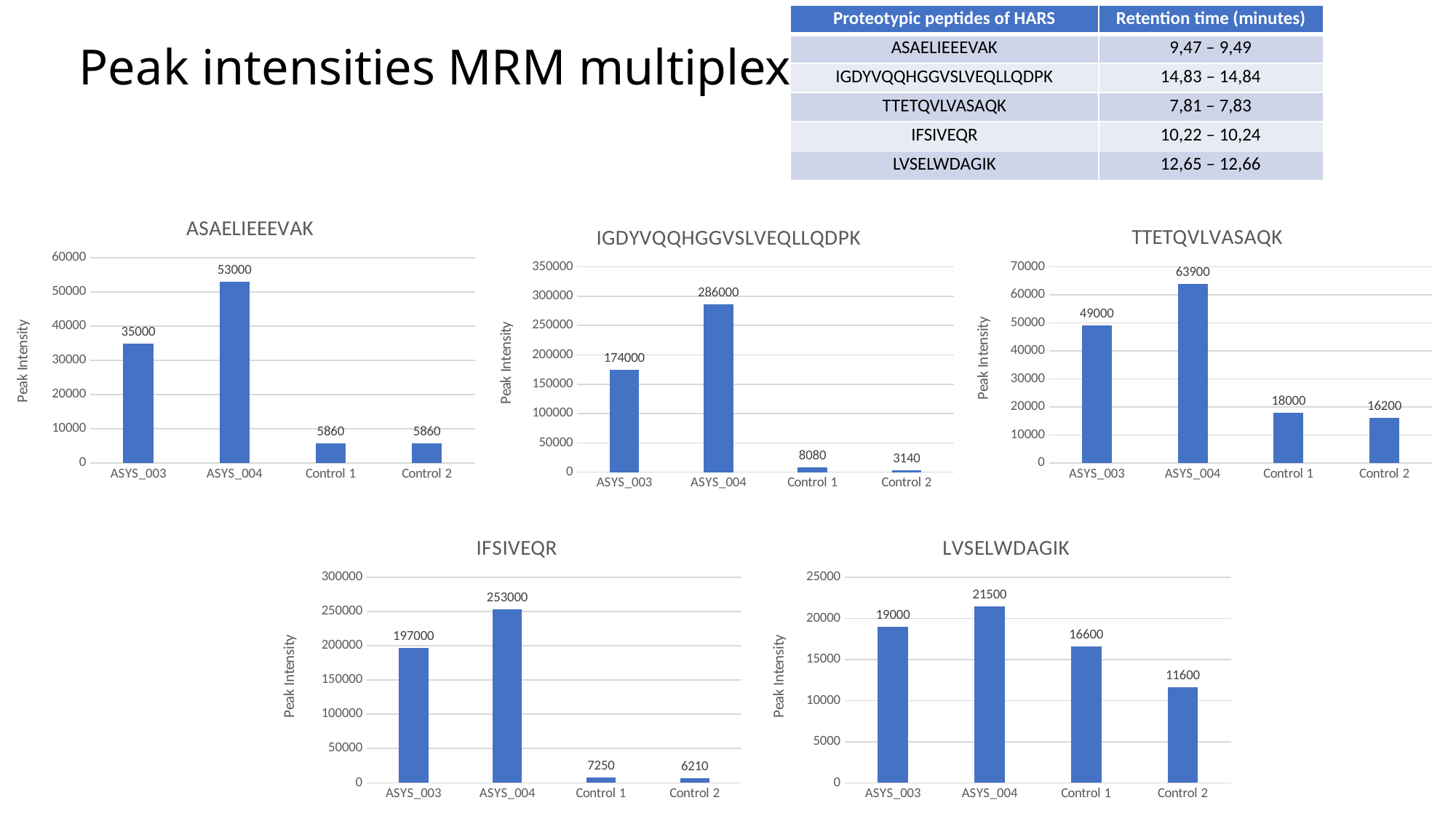
In the IGDYVQQHGGVSLVEQLLQDPK chart, what is the peak intensity for Control 2? 3140 In the ASAELIEEEVAK chart, what is the peak intensity for ASYS_004? 53000 In the TTETQVLVASAQK chart, which is larger, the value for Control 1 or Control 2? Control 1 In the TTETQVLVASAQK chart, which category has the highest peak intensity? ASYS_004 In the LVSELWDAGIK chart, which category has the lowest peak intensity? Control 2 How many categories are shown in the IFSIVEQR chart? 4 What kind of chart is the ASAELIEEEVAK chart? bar chart In the LVSELWDAGIK chart, what is the peak intensity for ASYS_003? 19000 In the ASAELIEEEVAK chart, what is the difference between the peak intensities of ASYS_003 and Control 1? 29140 In the IFSIVEQR chart, what is the difference between the peak intensities of ASYS_004 and ASYS_003? 56000 In the LVSELWDAGIK chart, is the value for Control 1 greater or less than 15000? greater How many bar charts are shown on the slide? 5